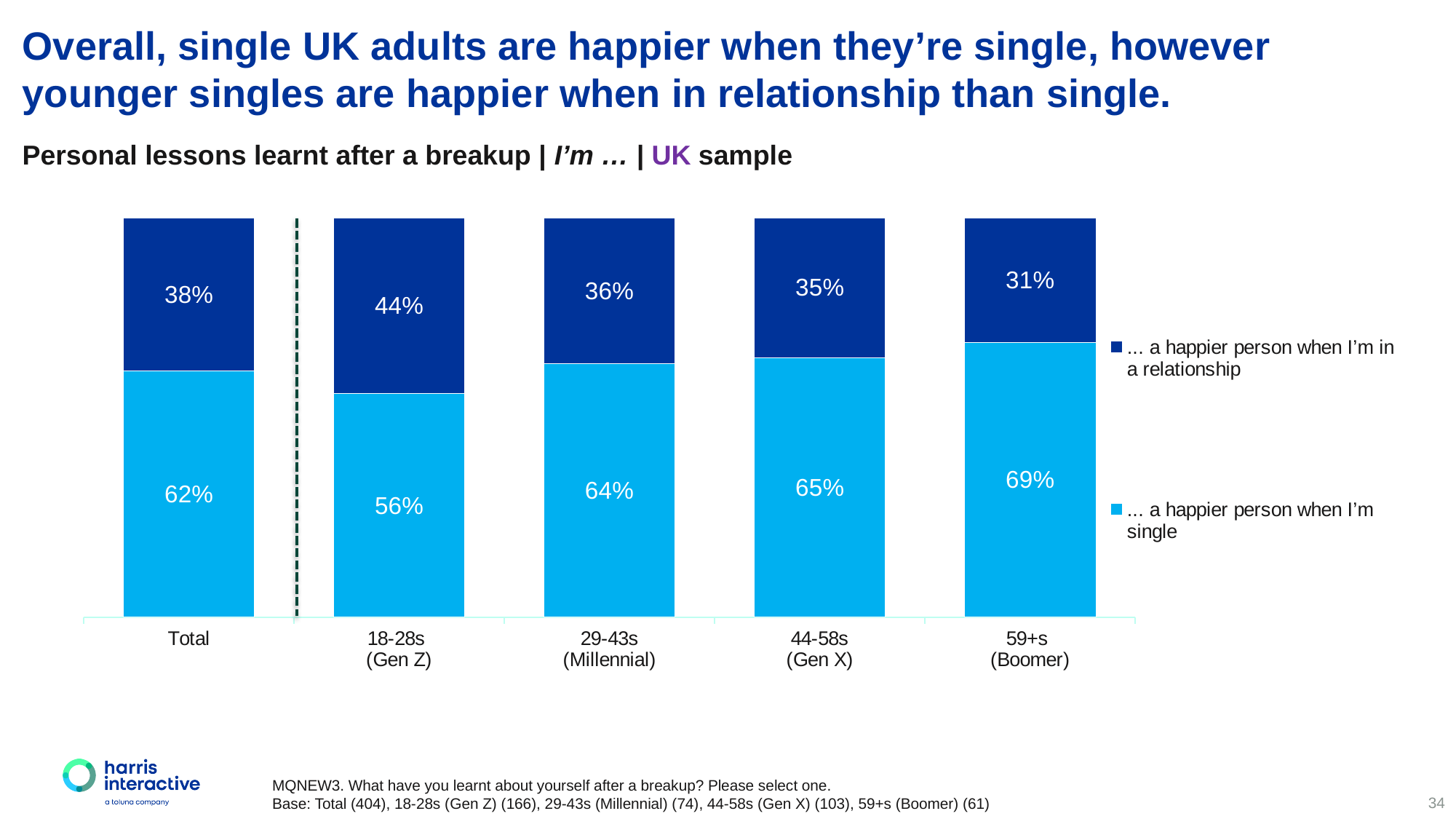
Which age group has the lowest share saying they are a happier person when in a relationship? 59+s (Boomer) What percentage of 18-28s (Gen Z) say they are a happier person when in a relationship? 44% What is the difference between the 'happier when single' share for 59+s (Boomer) and for 18-28s (Gen Z)? 13 percentage points Which age group has the highest share saying they are a happier person when single? 59+s (Boomer) Moving from 18-28s (Gen Z) to 59+s (Boomer), does the share saying they are happier when single rise or fall? Rise What percentage of the Total sample say they are a happier person when single? 62% What is the total of the stacked bar for 44-58s (Gen X)? 100% How many categories are shown on the x axis? 5 What kind of chart is shown on the slide? Stacked bar chart What percentage of 59+s (Boomer) say they are a happier person when single? 69% How many series does the legend list? 2 Which is larger for 29-43s (Millennial): the share happier when single or the share happier when in a relationship? Happier when single (64%)